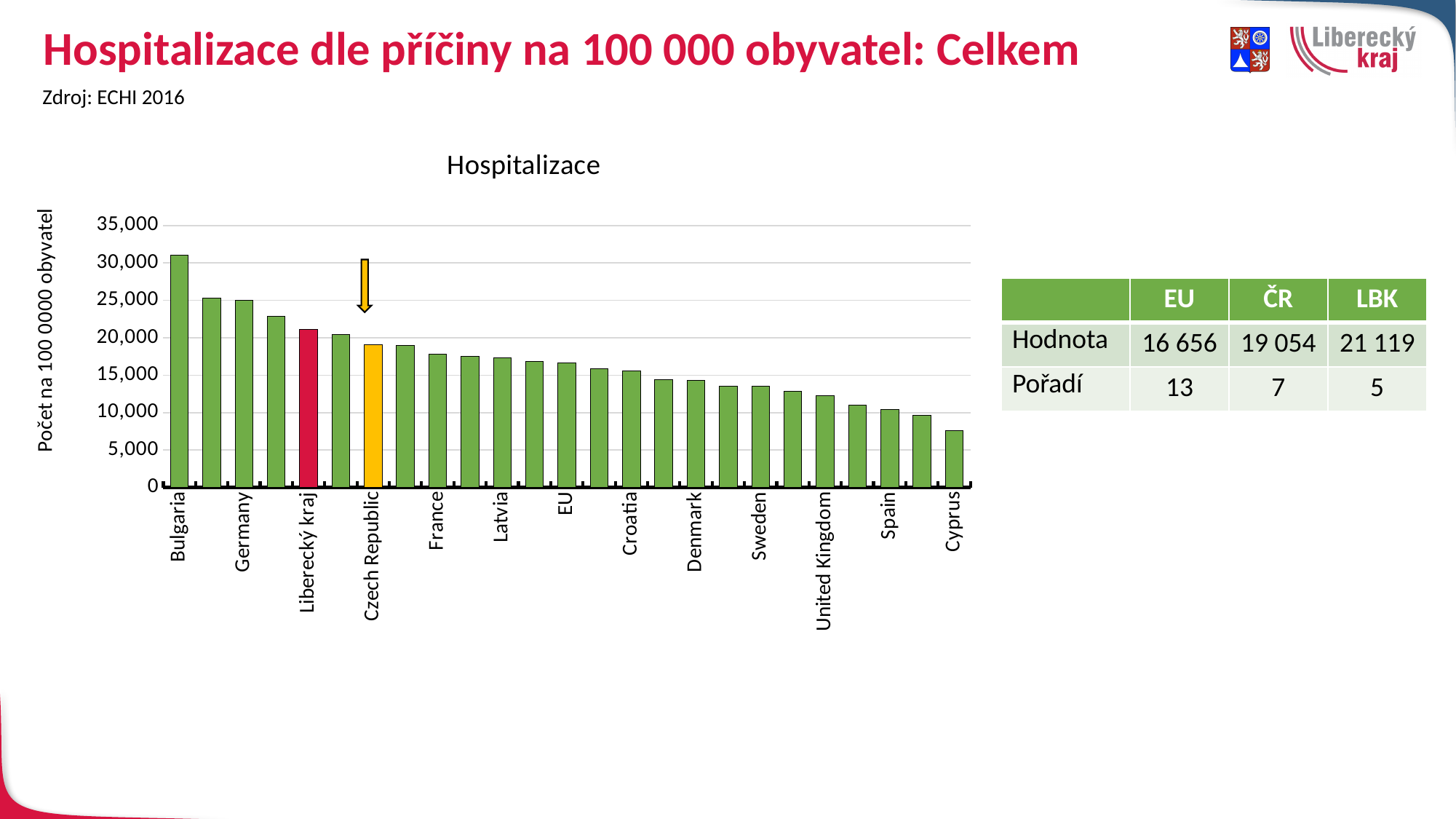
Do the values rise or fall from left to right along the x axis? fall According to the table next to the chart, what is the value (Hodnota) for LBK? 21 119 How many bars are plotted in the chart? 25 Is the value for France greater or less than 20,000? less Which country has the highest hospitalisation rate in the chart? Bulgaria Is the value for Bulgaria greater or less than 30,000? greater What kind of chart is shown on the slide? bar chart What is the title of the chart? Hospitalizace Which country has the lowest hospitalisation rate in the chart? Cyprus Is the value for Cyprus greater or less than 10,000? less Which is larger, the value for Liberecký kraj or the value for Czech Republic? Liberecký kraj According to the table next to the chart, what is the difference between the value for ČR and the value for EU? 2 398